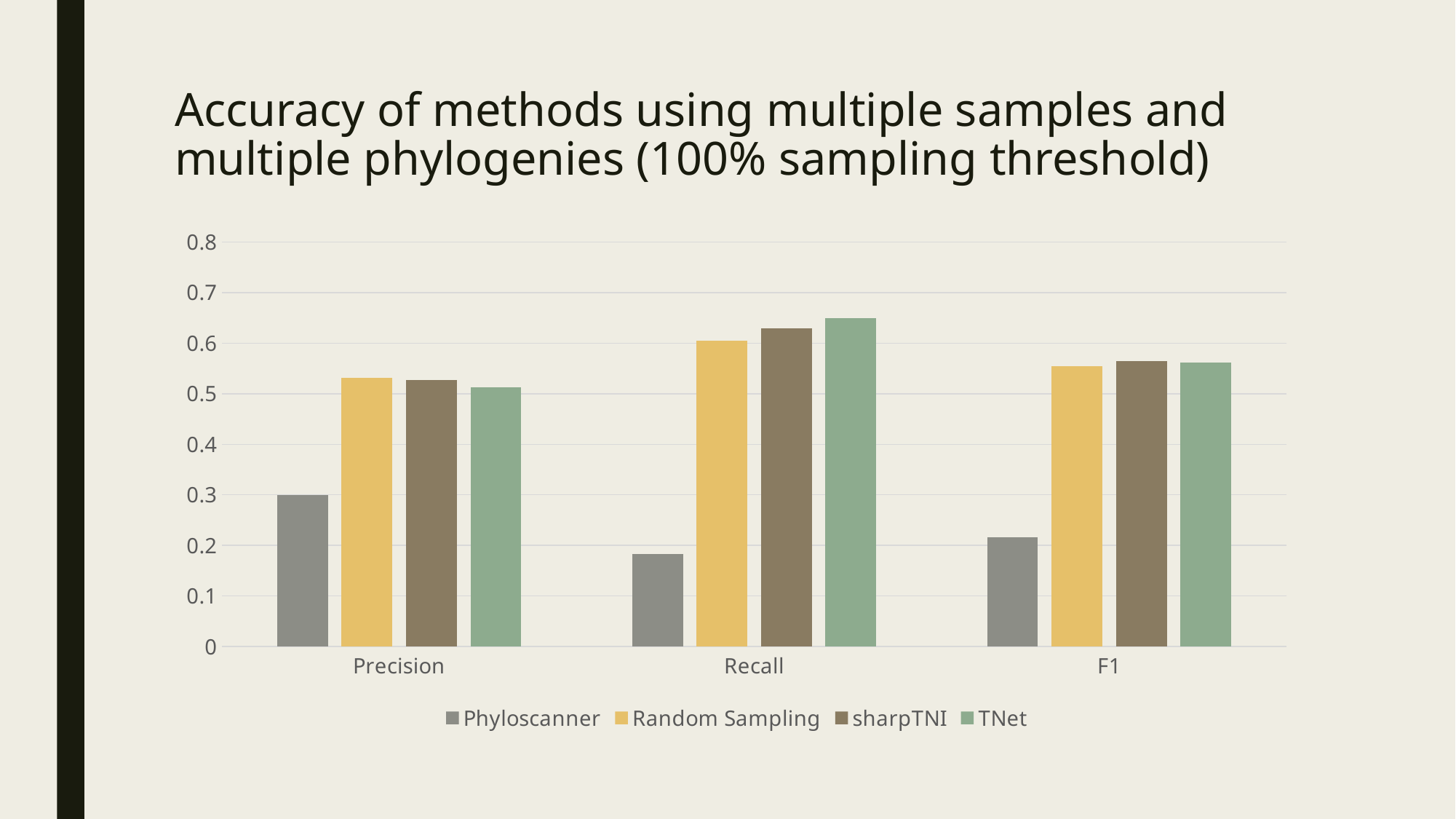
Which method has the lowest F1? Phyloscanner Which method has the lowest Recall? Phyloscanner How many categories are shown on the x axis? 3 Is the Recall value for Phyloscanner greater or less than 0.2? less Which method has the lowest Precision? Phyloscanner Which series is shown in yellow in the legend? Random Sampling How many series does the legend list? 4 Is the Precision value for Random Sampling greater or less than 0.5? greater Which is larger for Phyloscanner: its Precision or its Recall? Precision What kind of chart is shown on the slide? bar chart Which is larger for TNet: its Recall or its Precision? Recall Is the Recall value for TNet greater or less than 0.6? greater